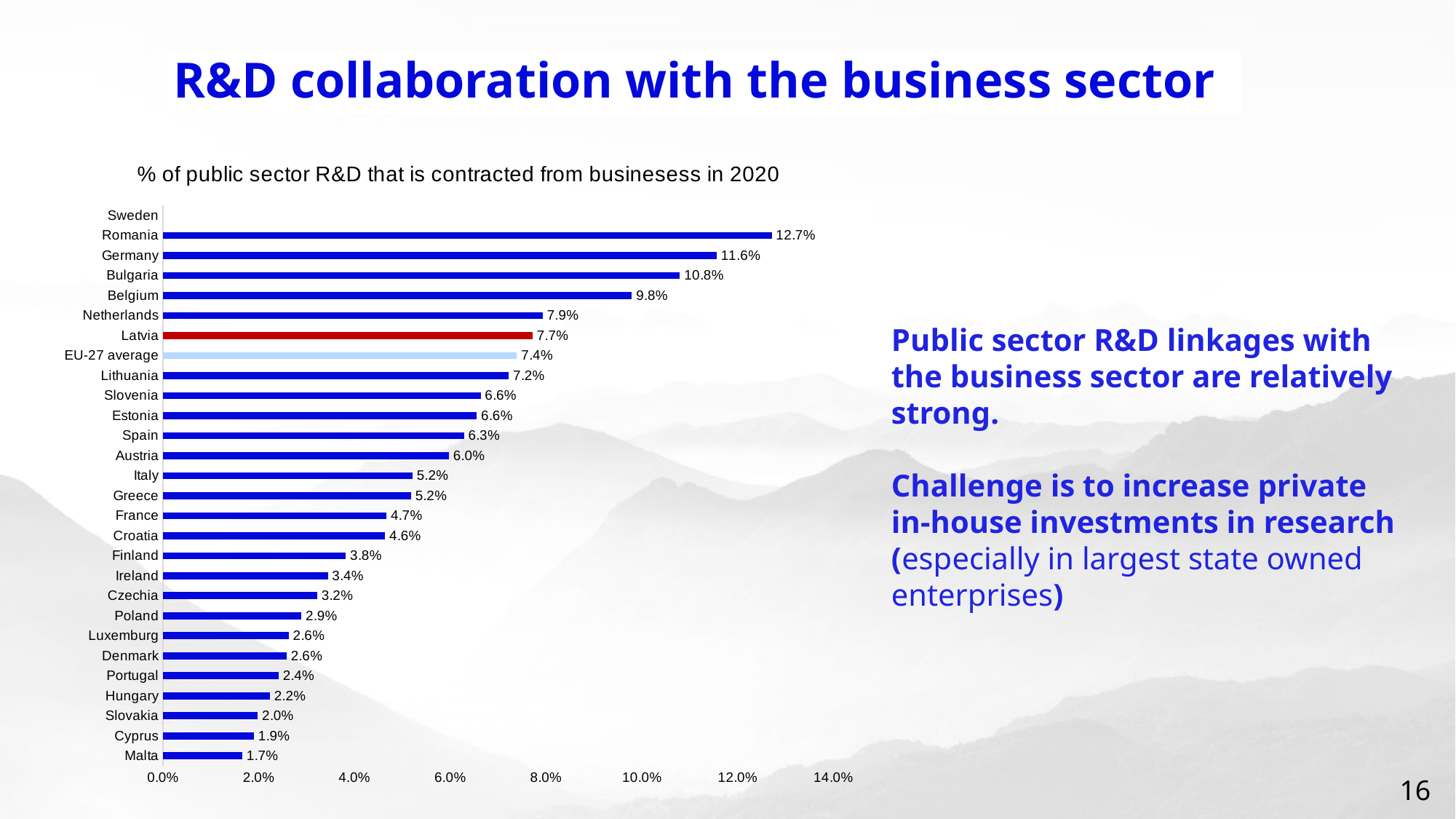
What is the value for the EU-27 average? 7.4% What is the difference between Romania's and Germany's values? 1.1 percentage points What kind of chart is shown on the slide? Bar chart What colour is the bar for Latvia? Red Which country has the highest value shown? Romania Is the value for Bulgaria greater or less than 10.0%? greater Which country has the lowest value shown? Malta What is the difference between Latvia's value and the EU-27 average? 0.3 percentage points What is the value for Romania? 12.7% What is the value for Finland? 3.8% Which has a larger value, Belgium or the Netherlands? Belgium What is the value for Latvia? 7.7%